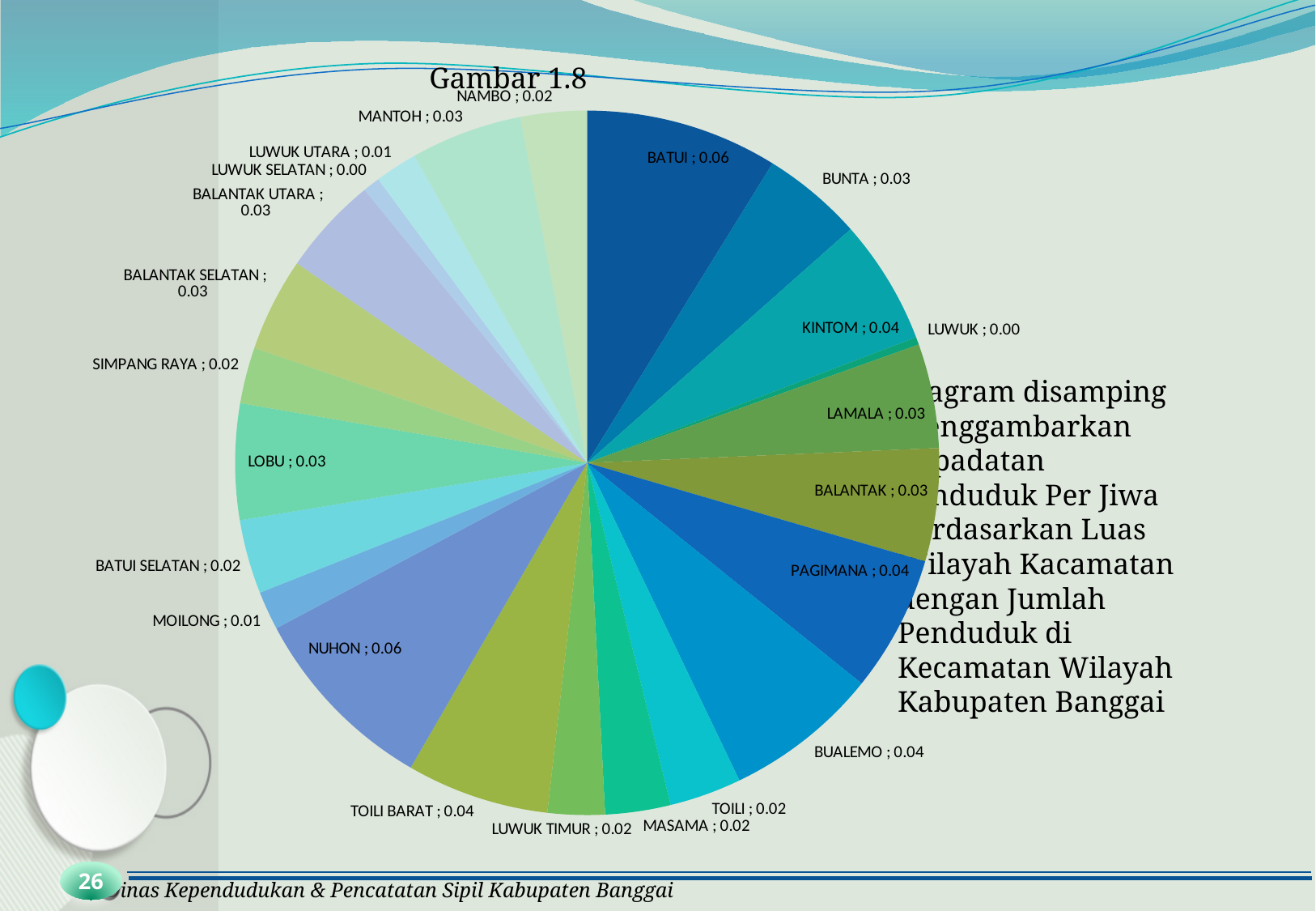
What is the value shown for LUWUK SELATAN? 0.00 What is the value shown for BATUI? 0.06 What type of chart is shown on the slide? pie chart What is the value shown for MOILONG? 0.01 Which has a larger value, KINTOM or MASAMA? KINTOM How many slices does the pie chart have? 23 What is the value shown for NUHON? 0.06 What is the value shown for TOILI BARAT? 0.04 What is the title of the chart? Gambar 1.8 Which has a larger value, BATUI or BUNTA? BATUI What is the difference between the values for BATUI and BUNTA? 0.03 What is the value shown for PAGIMANA? 0.04